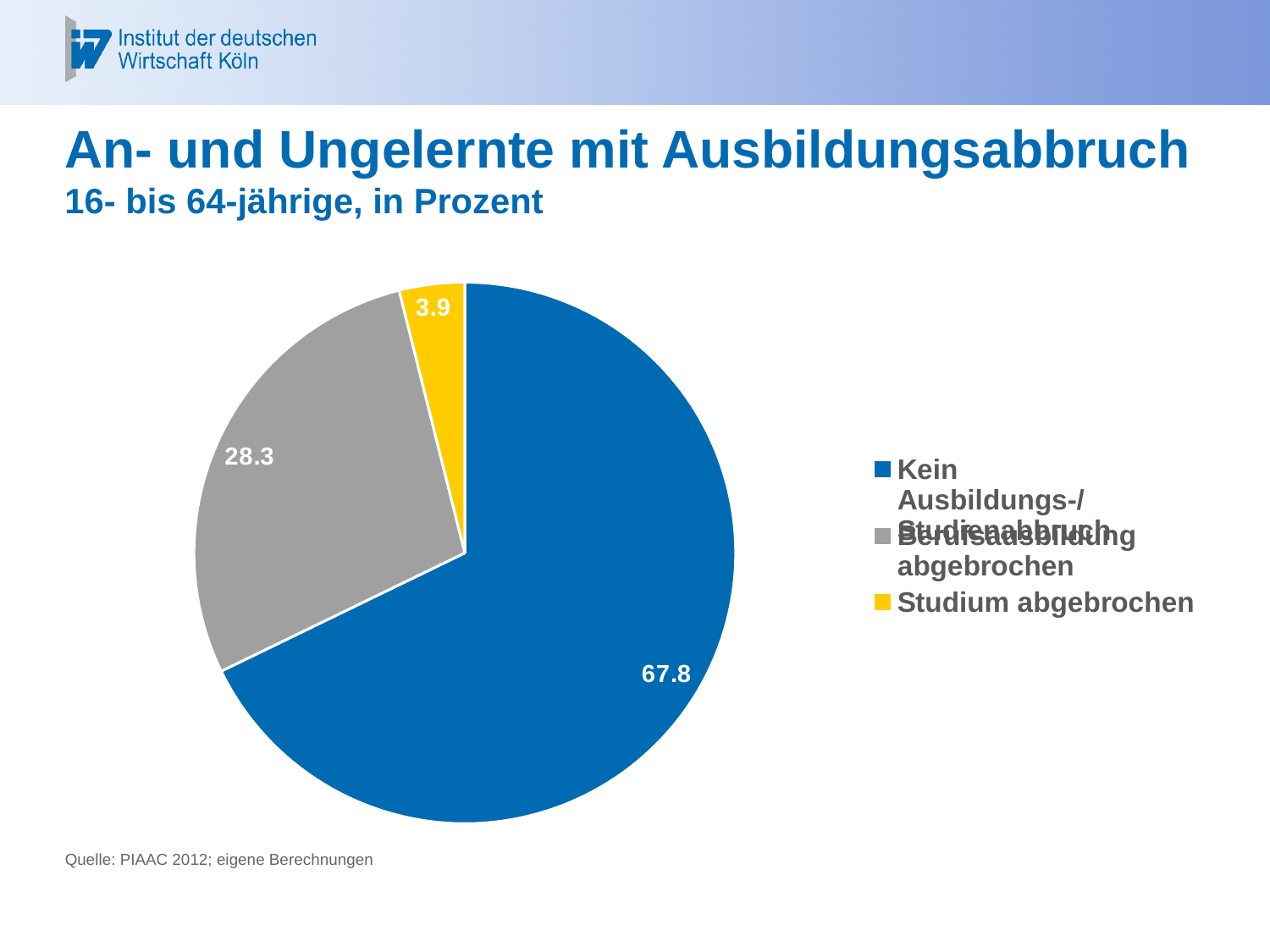
What colour is the "Studium abgebrochen" slice? yellow How many slices does the pie chart have? 3 What is the value of the grey slice ("Berufsausbildung abgebrochen")? 28.3 What is the difference between the grey slice (28.3) and the yellow slice (3.9)? 24.4 What is the value of the blue slice ("Kein Ausbildungs-/Studienabbruch")? 67.8 What kind of chart is shown on the slide? pie chart Which category has the largest slice of the pie? Kein Ausbildungs-/Studienabbruch Which is larger, the "Berufsausbildung abgebrochen" slice or the "Studium abgebrochen" slice? Berufsausbildung abgebrochen What is the value of the "Studium abgebrochen" slice? 3.9 Which category has the smallest slice of the pie? Studium abgebrochen How many entries does the legend list? 3 What is the difference between the blue slice (67.8) and the grey slice (28.3)? 39.5